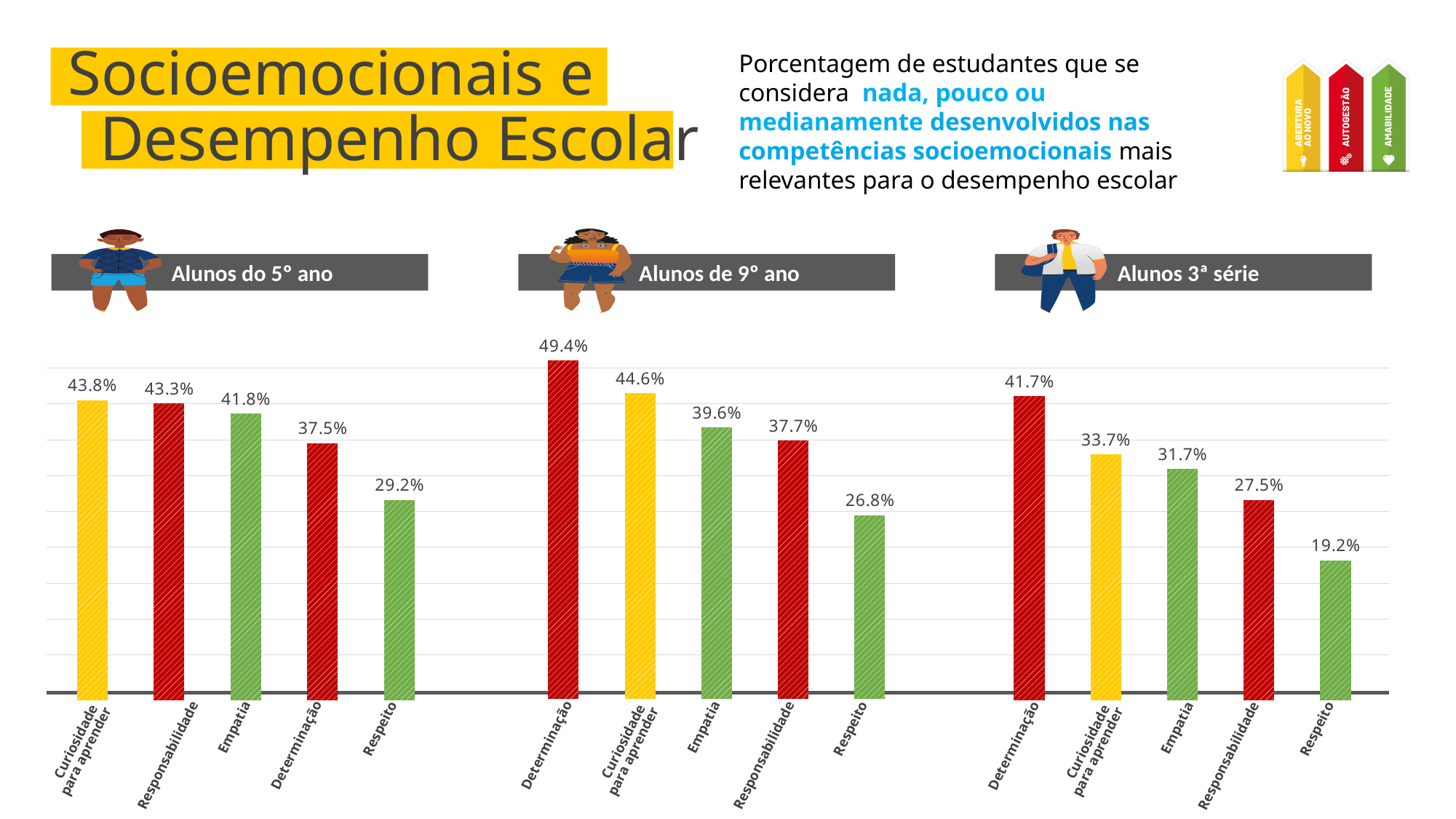
In the 'Alunos 3ª série' chart, what is the difference between Determinação and Curiosidade para aprender? 8.0% Which is larger: Empatia in the 'Alunos de 9° ano' chart or Empatia in the 'Alunos 3ª série' chart? Alunos de 9° ano How many categories are shown in the 'Alunos de 9° ano' chart? 5 In the 'Alunos de 9° ano' chart, which category has the highest value? Determinação In the 'Alunos do 5° ano' chart, which category has the lowest value? Respeito In the 'Alunos do 5° ano' chart, what is the value for Curiosidade para aprender? 43.8% In the 'Alunos de 9° ano' chart, what is the value for Respeito? 26.8% What type of chart is used for the 'Alunos do 5° ano' data? Bar chart In the 'Alunos 3ª série' chart, what colour is the Respeito bar? Green In the 'Alunos do 5° ano' chart, what is the difference between Curiosidade para aprender and Respeito? 14.6% In the 'Alunos 3ª série' chart, which category has the lowest value? Respeito In the 'Alunos 3ª série' chart, what is the value for Empatia? 31.7%